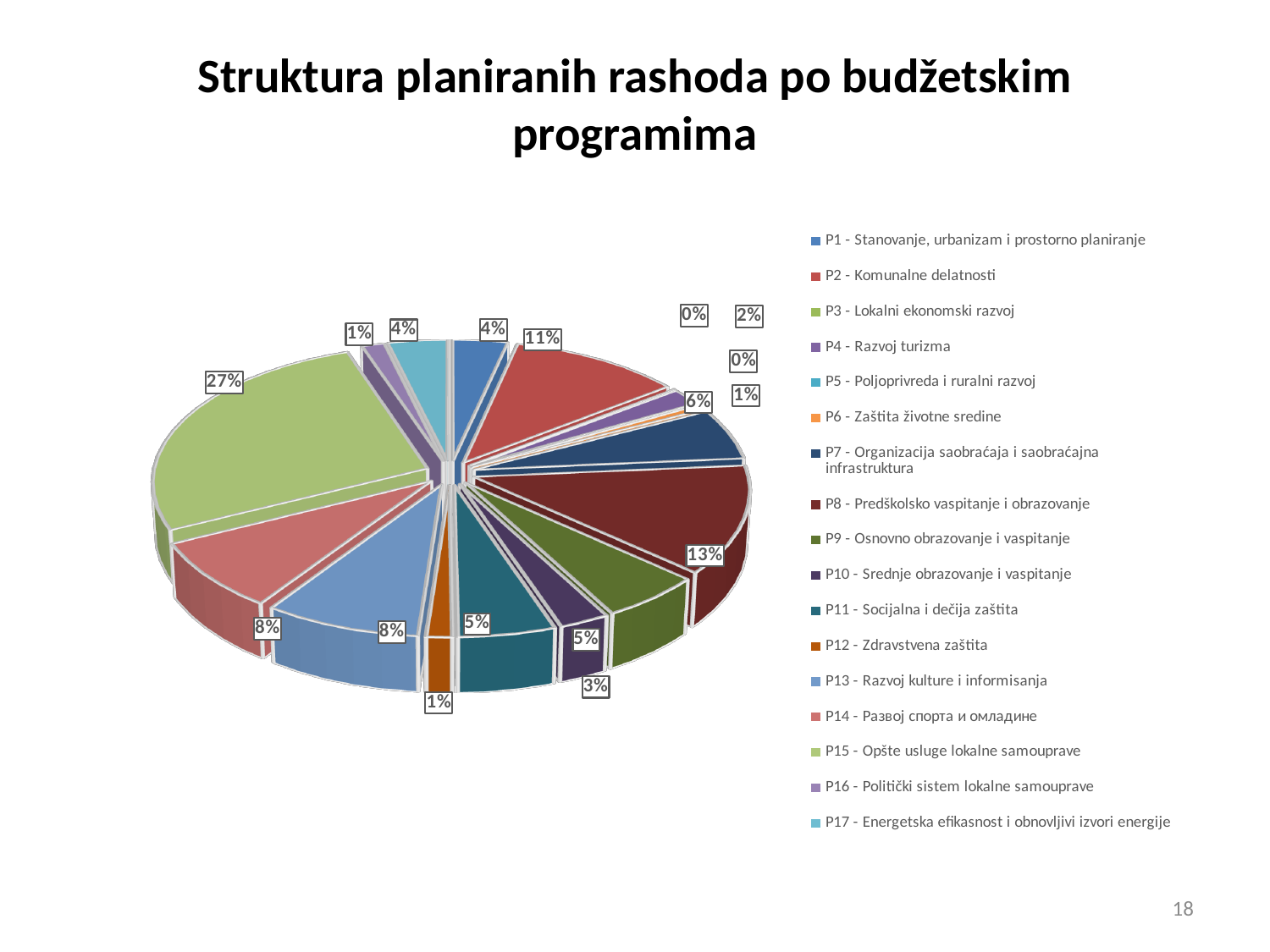
What share of planned expenditures goes to P8 - Predškolsko vaspitanje i obrazovanje? 13% What share of planned expenditures goes to P1 - Stanovanje, urbanizam i prostorno planiranje? 4% Which has a larger share: P2 - Komunalne delatnosti or P8 - Predškolsko vaspitanje i obrazovanje? P8 - Predškolsko vaspitanje i obrazovanje What kind of chart is shown on the slide? pie chart Which program has the largest share of planned expenditures? P15 - Opšte usluge lokalne samouprave How many programs (categories) does the legend list? 17 What share of planned expenditures goes to P15 - Opšte usluge lokalne samouprave? 27% What is the difference in percentage points between the share of P15 - Opšte usluge lokalne samouprave and P8 - Predškolsko vaspitanje i obrazovanje? 14% What is the title of the chart? Struktura planiranih rashoda po budžetskim programima